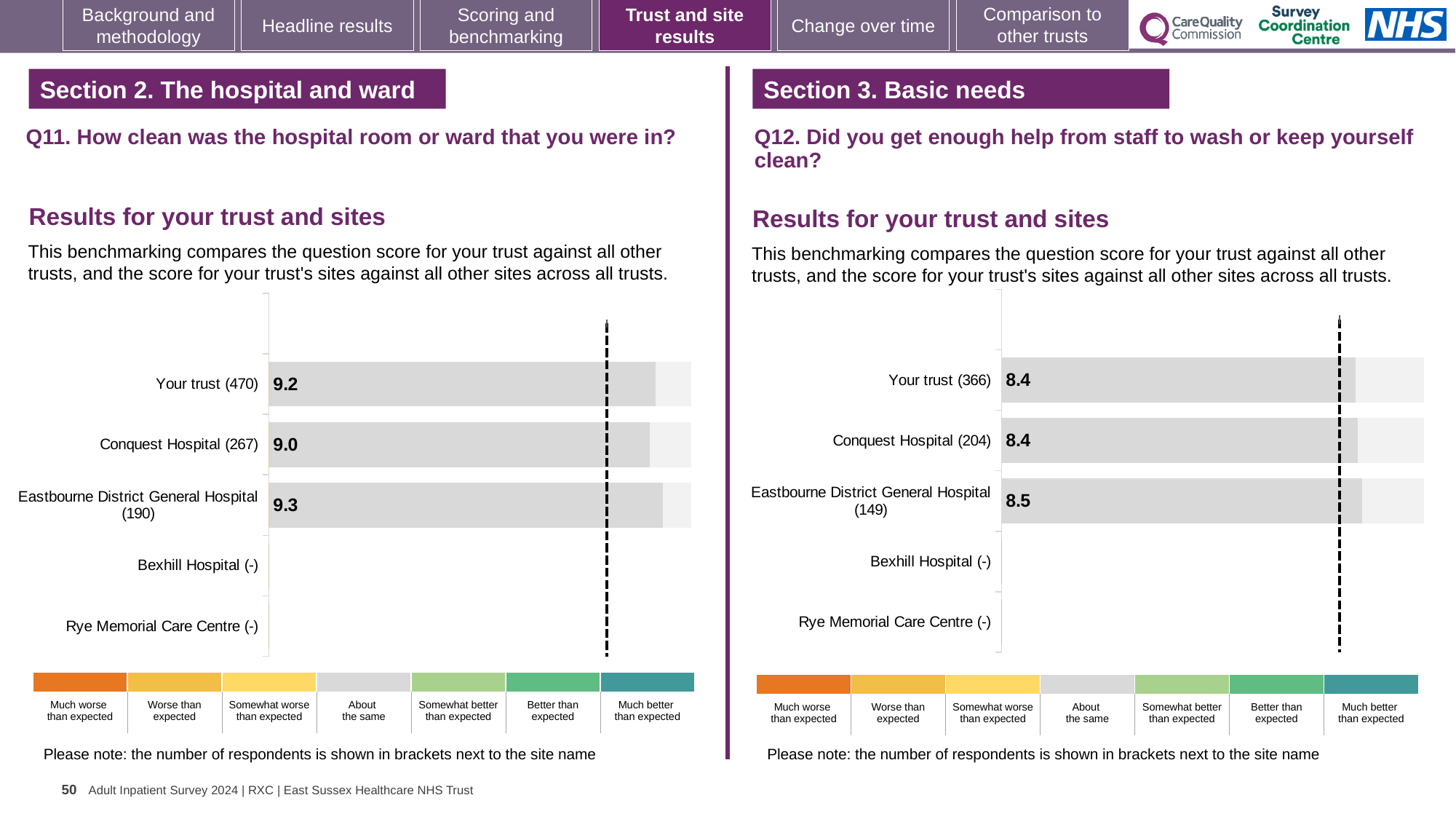
In the Q12 chart on the right, what is the score for Your trust (366)? 8.4 In the Q11 chart on the left, how many categories does the colour legend below the chart list? 7 In the Q12 chart on the right, how many respondents are shown for Conquest Hospital? 204 In the Q12 chart on the right, what is the difference between the scores for Eastbourne District General Hospital (149) and Your trust (366)? 0.1 In the Q11 chart on the left, which site has the highest score? Eastbourne District General Hospital (190) In the Q11 chart on the left, what is the score for Your trust (470)? 9.2 In the Q12 chart on the right, which of Your trust (366) or Conquest Hospital (204) has the higher score? They are equal (8.4) In the Q11 chart on the left, how many site or trust categories are listed on the vertical axis? 5 In the Q11 chart on the left, what is the difference between the scores for Eastbourne District General Hospital (190) and Conquest Hospital (267)? 0.3 What type of chart is used in the Q11 chart on the left? Bar chart In the Q11 chart on the left, what is the score for Conquest Hospital (267)? 9.0 In the Q12 chart on the right, what is the score for Eastbourne District General Hospital (149)? 8.5